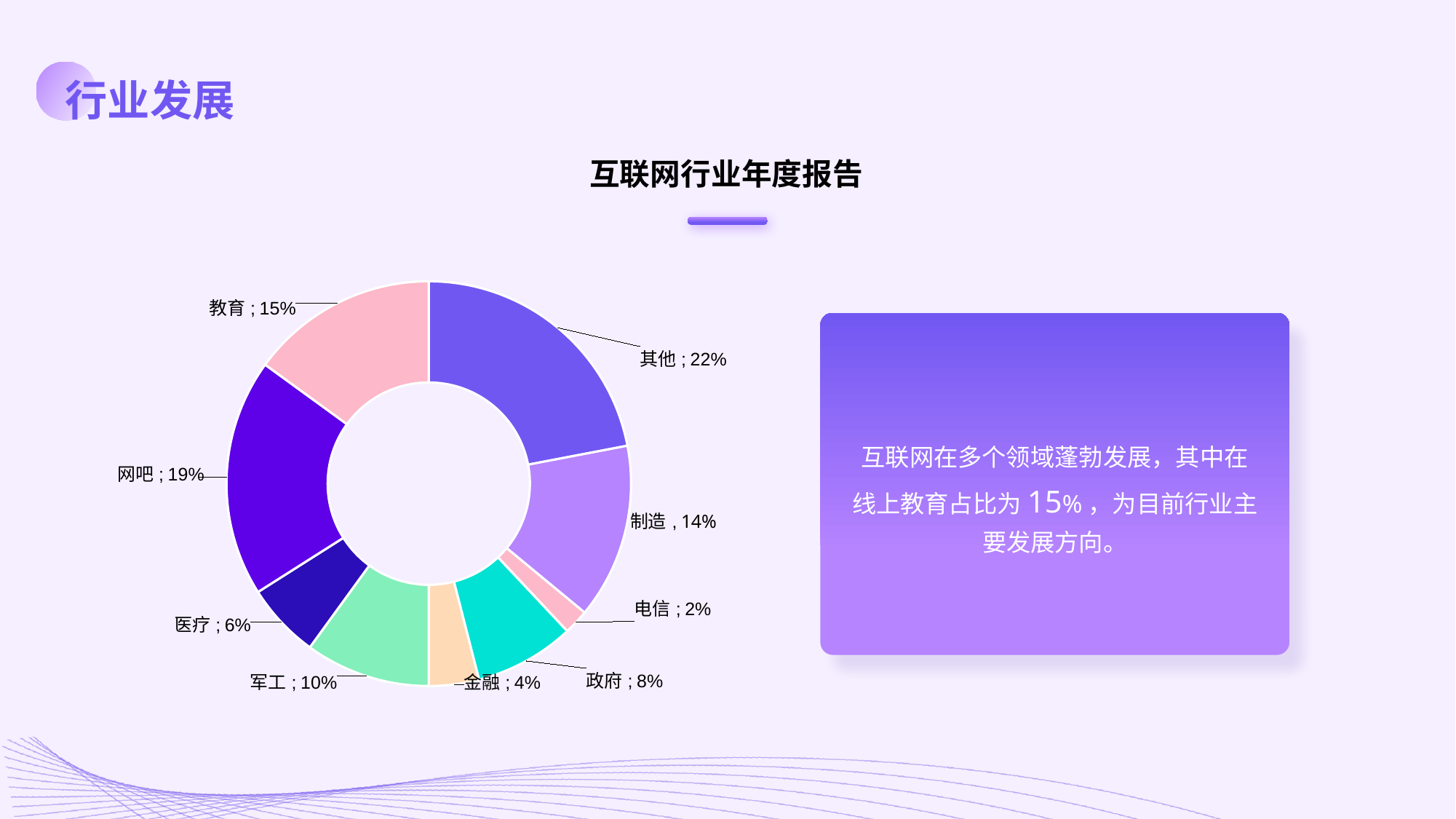
Which is larger, the share of 政府 or the share of 金融? 政府 What is the value shown for 网吧? 19% Which category has the smallest share in the chart? 电信 What is the title of the chart? 互联网行业年度报告 How many categories are shown in the chart? 9 What kind of chart is shown on the slide? Pie chart (donut) What is the value shown for 电信? 2% What is the difference between the shares of 网吧 and 医疗? 13% What is the combined share of 军工 and 金融? 14% What percentage does 教育 account for in the chart? 15% What is the value shown for 制造? 14% Which category has the largest share in the chart? 其他